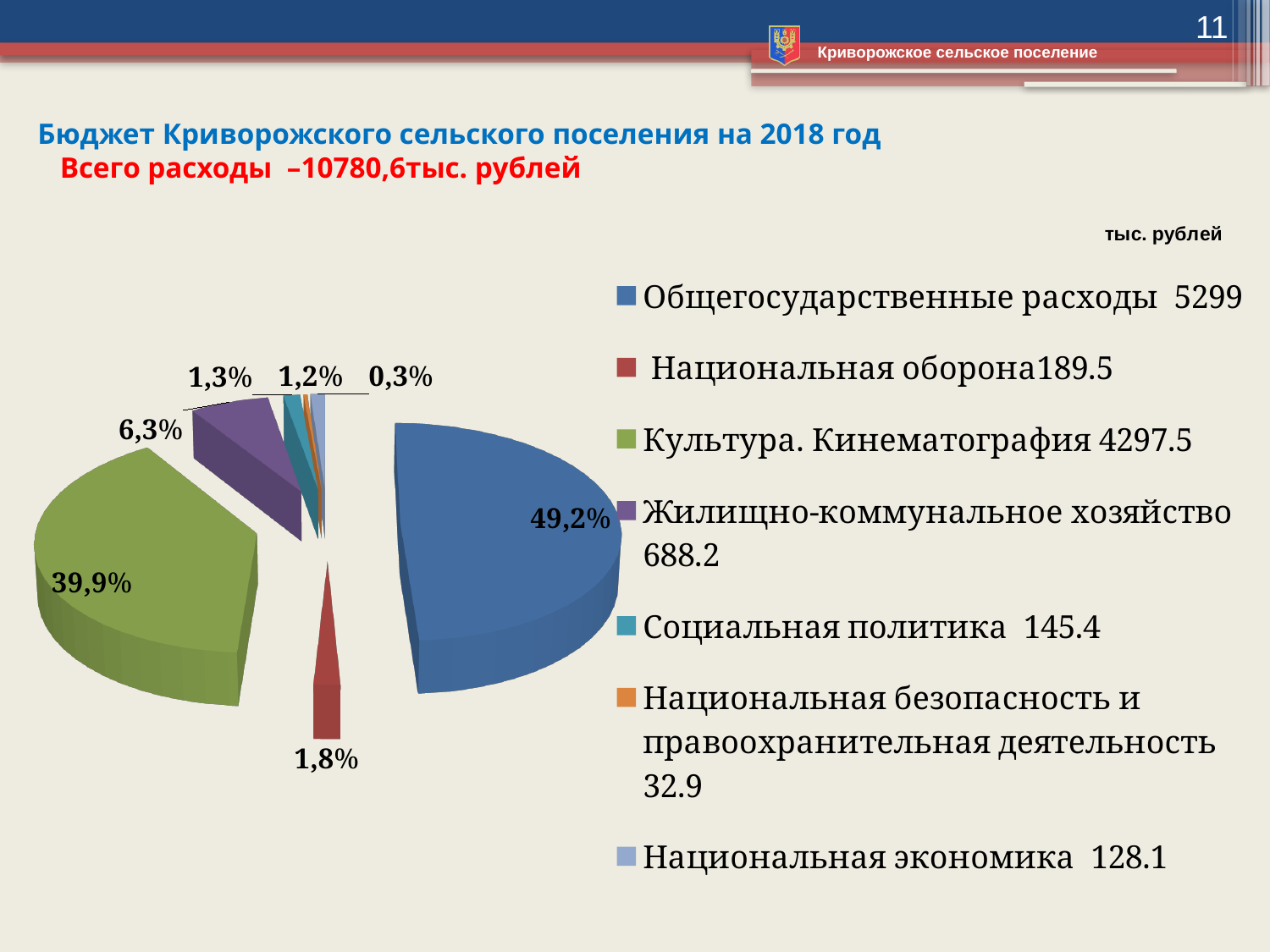
What is the value for Жилищно-коммунальное хозяйство in the legend? 688.2 What share of the pie does Общегосударственные расходы take? 49,2% Which is larger, Национальная оборона or Социальная политика? Национальная оборона How many categories does the legend of the pie chart list? 7 What is the value for Культура. Кинематография in the legend? 4297.5 Which category has the largest slice of the pie? Общегосударственные расходы Which category has the smallest slice of the pie? Национальная безопасность и правоохранительная деятельность What is the difference between Общегосударственные расходы and Культура. Кинематография? 1001.5 What kind of chart is shown on the slide? pie chart What is the value for Общегосударственные расходы in the legend? 5299 What share of the pie does Культура. Кинематография take? 39,9% What is the value for Национальная безопасность и правоохранительная деятельность in the legend? 32.9